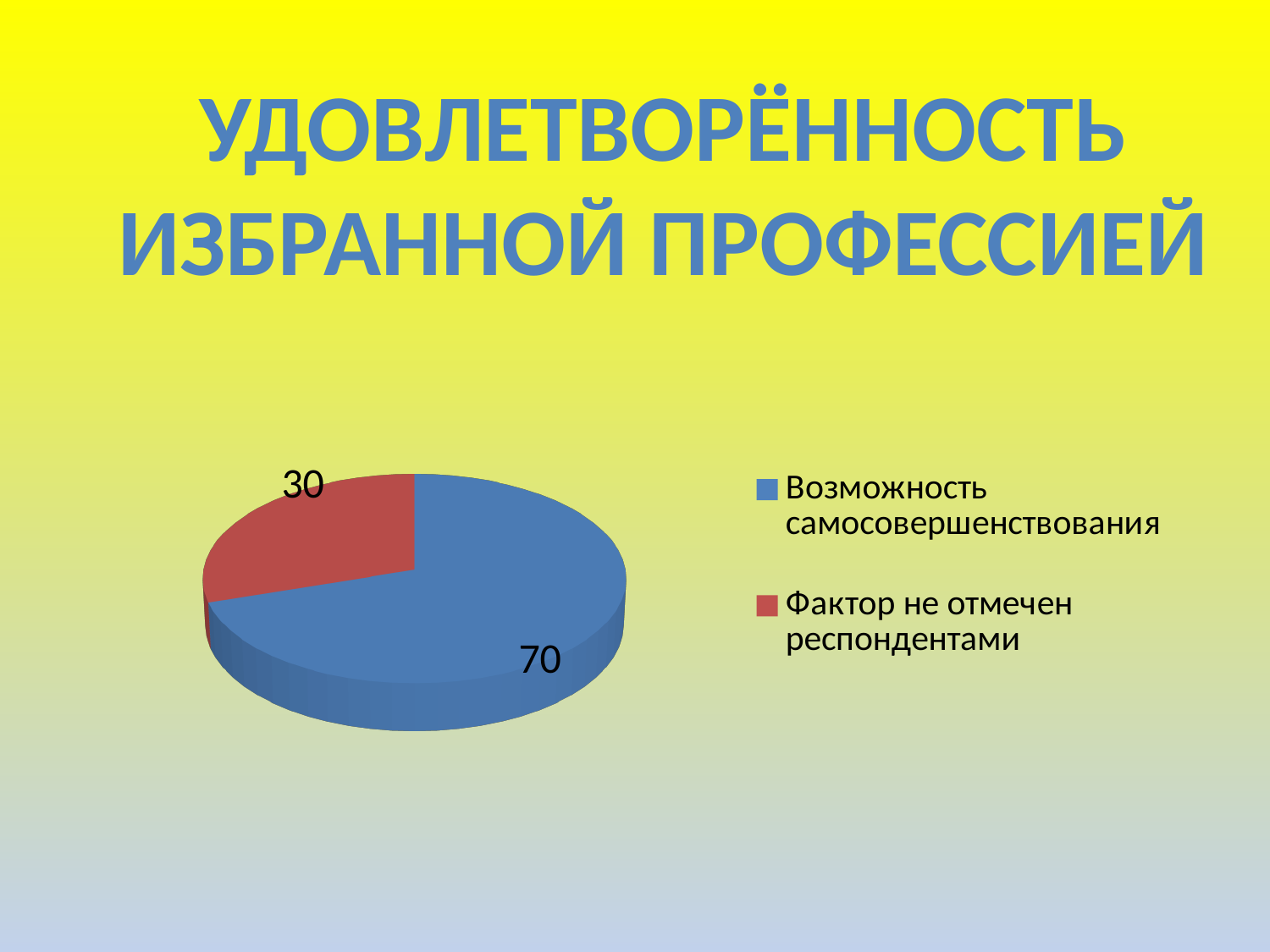
What is the title of the slide containing the chart? УДОВЛЕТВОРЁННОСТЬ ИЗБРАННОЙ ПРОФЕССИЕЙ Which category has the largest slice? Возможность самосовершенствования How many entries does the legend list? 2 What is the difference between the values for "Возможность самосовершенствования" and "Фактор не отмечен респондентами"? 40 What is the value for "Фактор не отмечен респондентами"? 30 What share of the pie does "Фактор не отмечен респондентами" represent? 30% Which is larger: "Возможность самосовершенствования" or "Фактор не отмечен респондентами"? Возможность самосовершенствования What kind of chart is shown on the slide? pie chart Which category has the smallest slice? Фактор не отмечен респондентами What colour is the slice for "Возможность самосовершенствования"? blue What is the value for "Возможность самосовершенствования"? 70 How many slices does the pie chart have? 2